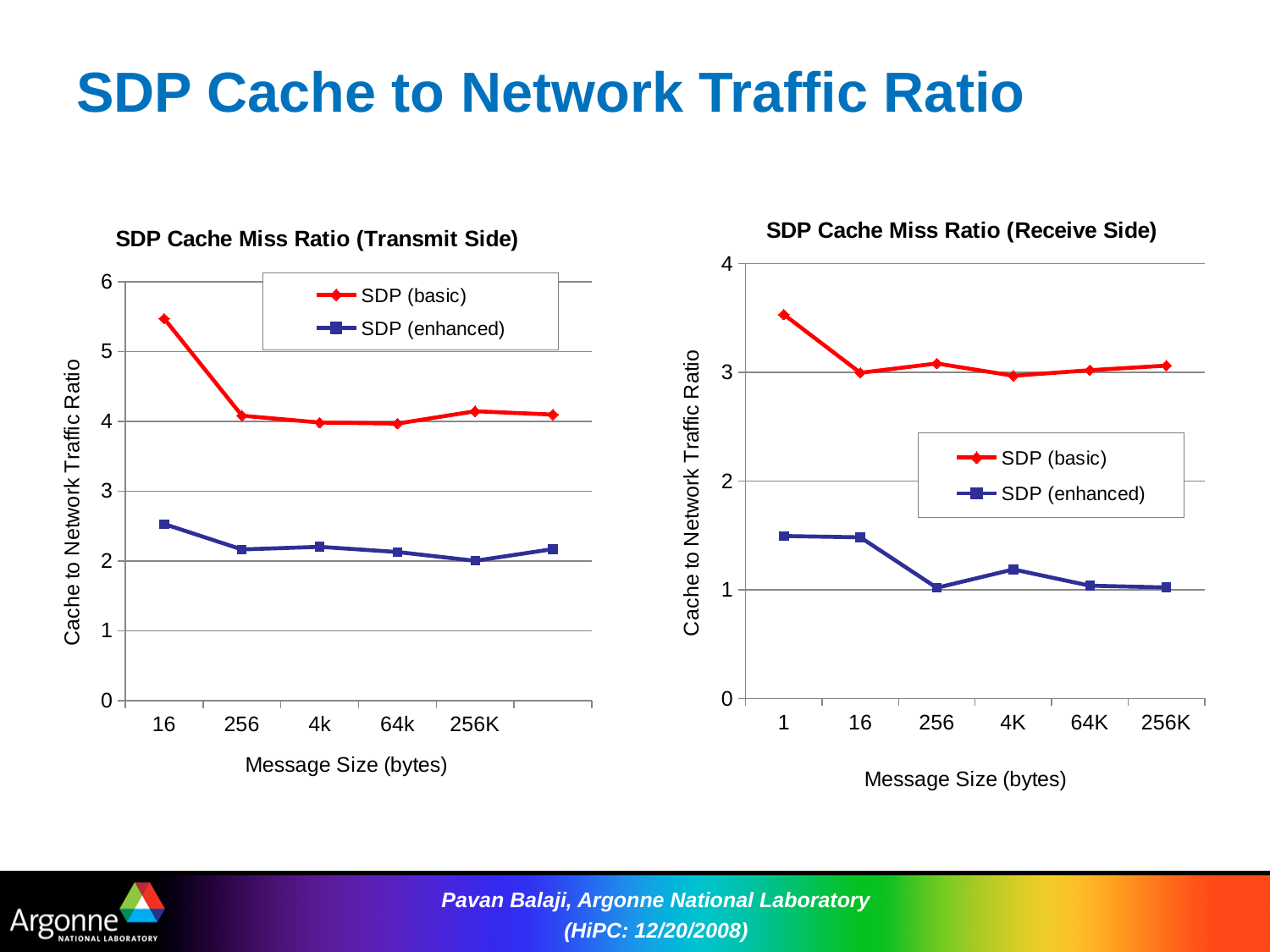
What is the y-axis label of the SDP Cache Miss Ratio (Receive Side) chart? Cache to Network Traffic Ratio What kind of chart is the SDP Cache Miss Ratio (Transmit Side) chart? line chart In the SDP Cache Miss Ratio (Transmit Side) chart, is the value for SDP (enhanced) at message size 16 greater or less than 2? greater In the SDP Cache Miss Ratio (Transmit Side) chart, is the value for SDP (basic) at message size 16 greater or less than 5? greater In the SDP Cache Miss Ratio (Receive Side) chart, which series has the larger value at message size 4K, SDP (basic) or SDP (enhanced)? SDP (basic) In the SDP Cache Miss Ratio (Receive Side) chart, at which message size is SDP (basic) highest? 1 How many series does the legend of the SDP Cache Miss Ratio (Receive Side) chart list? 2 How many message sizes are labeled on the x axis of the SDP Cache Miss Ratio (Receive Side) chart? 6 In the SDP Cache Miss Ratio (Transmit Side) chart, does the SDP (basic) line rise or fall from message size 16 to 256? fall In the SDP Cache Miss Ratio (Receive Side) chart, is the value for SDP (enhanced) at message size 1 greater or less than 2? less In the SDP Cache Miss Ratio (Transmit Side) chart, at which message size is SDP (basic) highest? 16